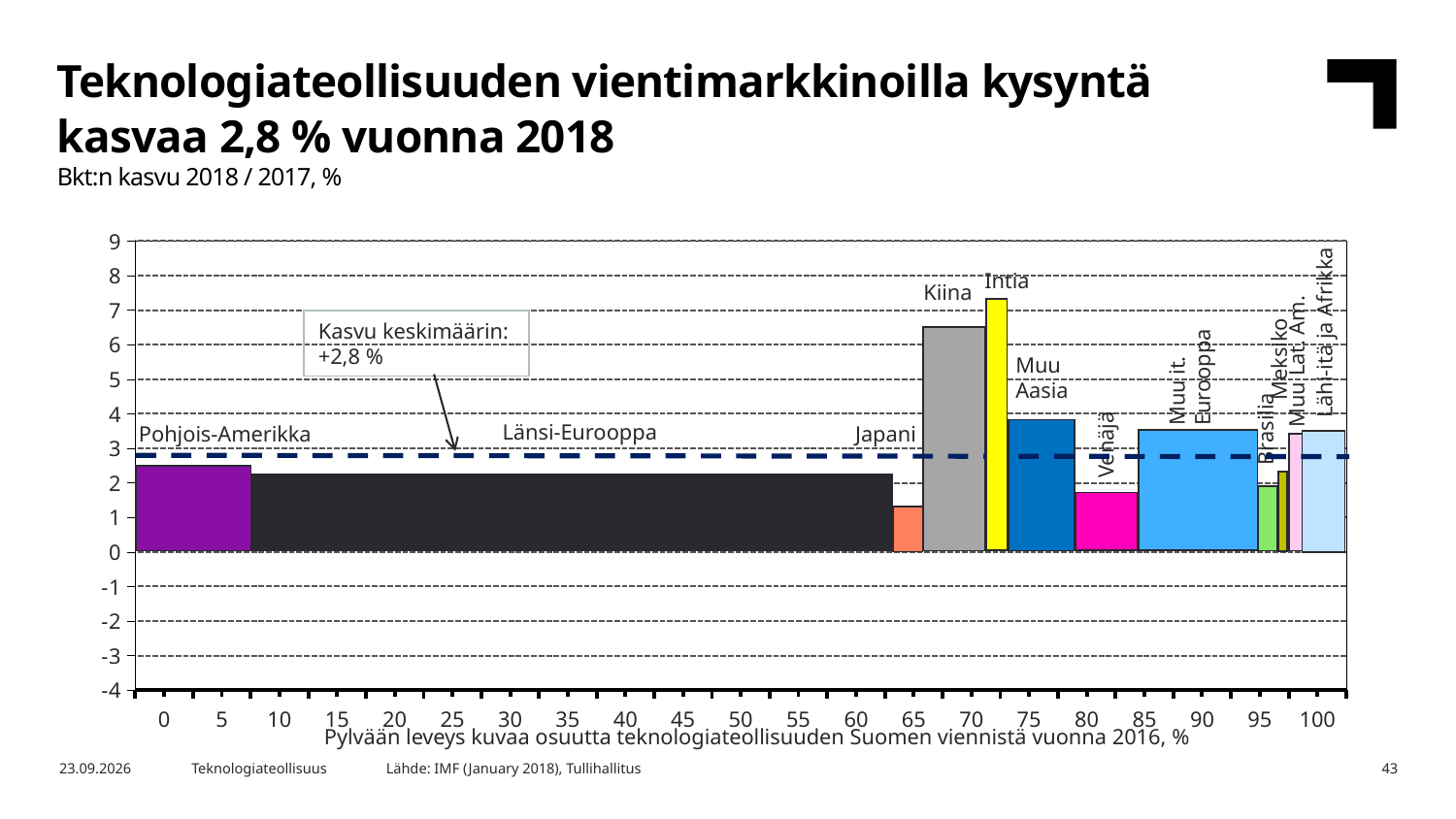
Is the value for Japani greater or less than 2? less Which has the larger value, Pohjois-Amerikka or Länsi-Eurooppa? Pohjois-Amerikka Is the value for Kiina greater or less than 6? greater What kind of chart is shown on the slide? bar chart Which has the larger value, Kiina or Intia? Intia How many regions (bars) are shown in the chart? 12 Is the value for Muu Aasia greater or less than 3? greater What is the average growth (Kasvu keskimäärin) shown on the chart? +2,8 % Which region has the highest GDP growth in the chart? Intia Which region has the lowest GDP growth in the chart? Japani